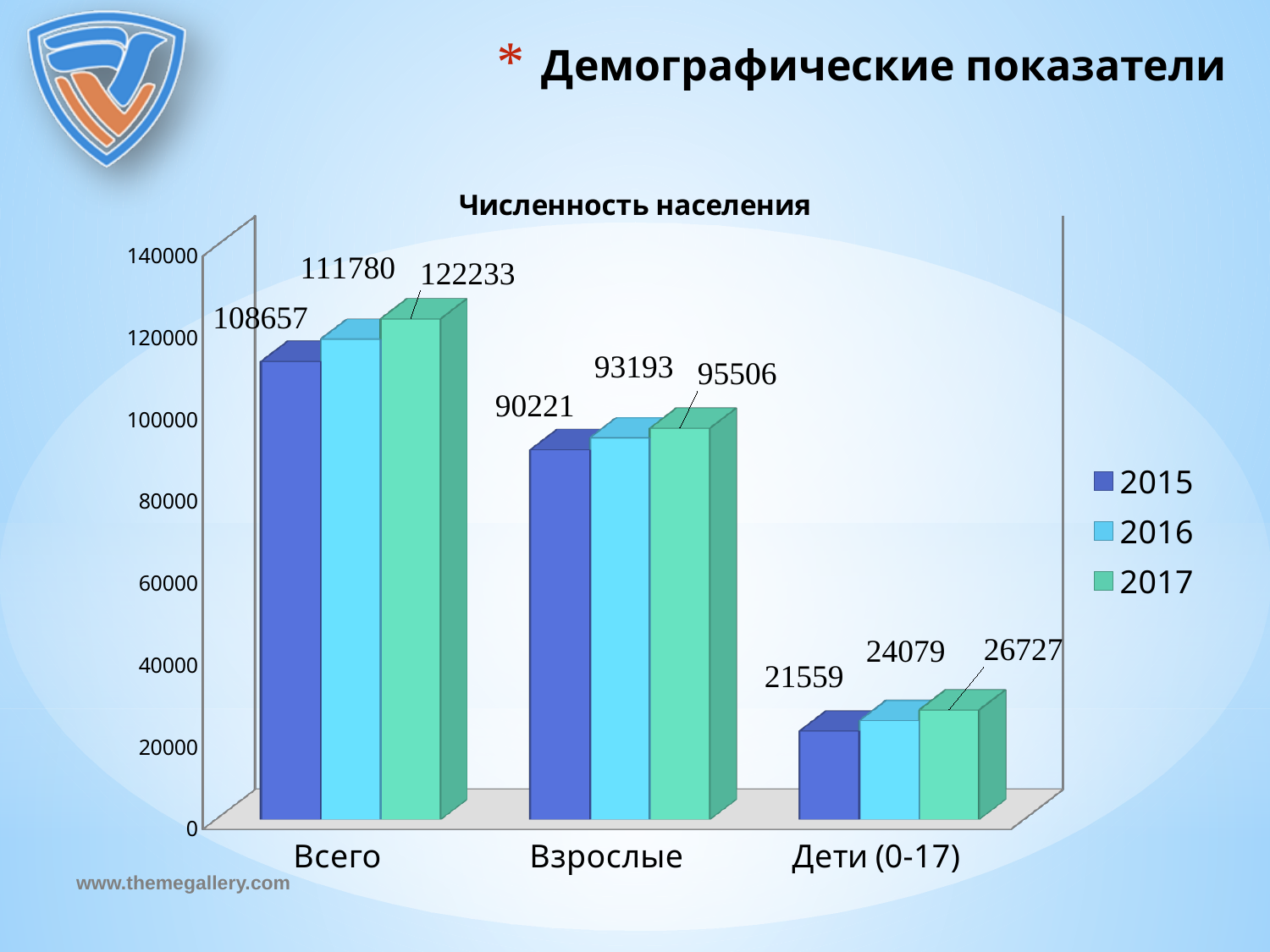
Is the value for Всего in 2015 greater or less than 100000? greater Which is larger: the 2016 value for Взрослые or the 2017 value for Взрослые? 2017 What is the value for Дети (0-17) in 2016? 24079 How many series does the legend list? 3 What is the difference between the 2016 and 2015 values for Дети (0-17)? 2520 What is the difference between the 2017 and 2015 values for Всего? 13576 How many categories are shown on the x axis? 3 Which category has the highest value in 2015? Всего What is the value for Всего in 2017? 122233 Which category has the lowest value in 2017? Дети (0-17) What is the value for Взрослые in 2015? 90221 What kind of chart is shown on the slide? bar chart